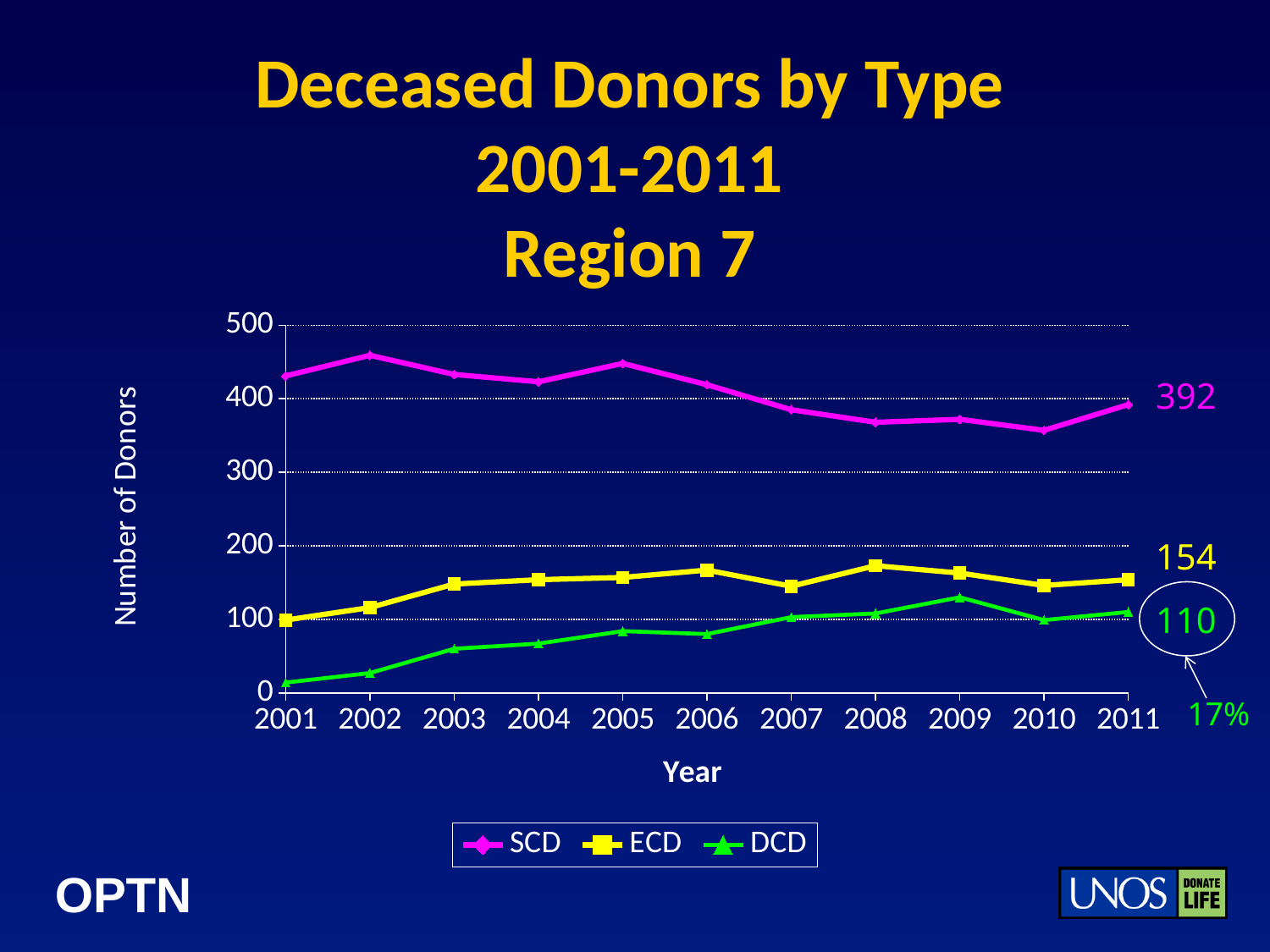
How many years are plotted along the x axis? 11 What is the difference between the SCD and ECD values in 2011? 238 Is the value for DCD in 2001 greater or less than 100? less What is the difference between the ECD and DCD values in 2011? 44 What is the number of ECD donors in 2011? 154 Which series has the highest values across all years? SCD How many series does the legend list? 3 Does the DCD series generally rise or fall from 2001 to 2011? rise Is the value for SCD in 2002 greater or less than 400? greater What is the number of DCD donors in 2011? 110 What is the number of SCD donors in 2011? 392 What type of chart is shown on the slide? line chart